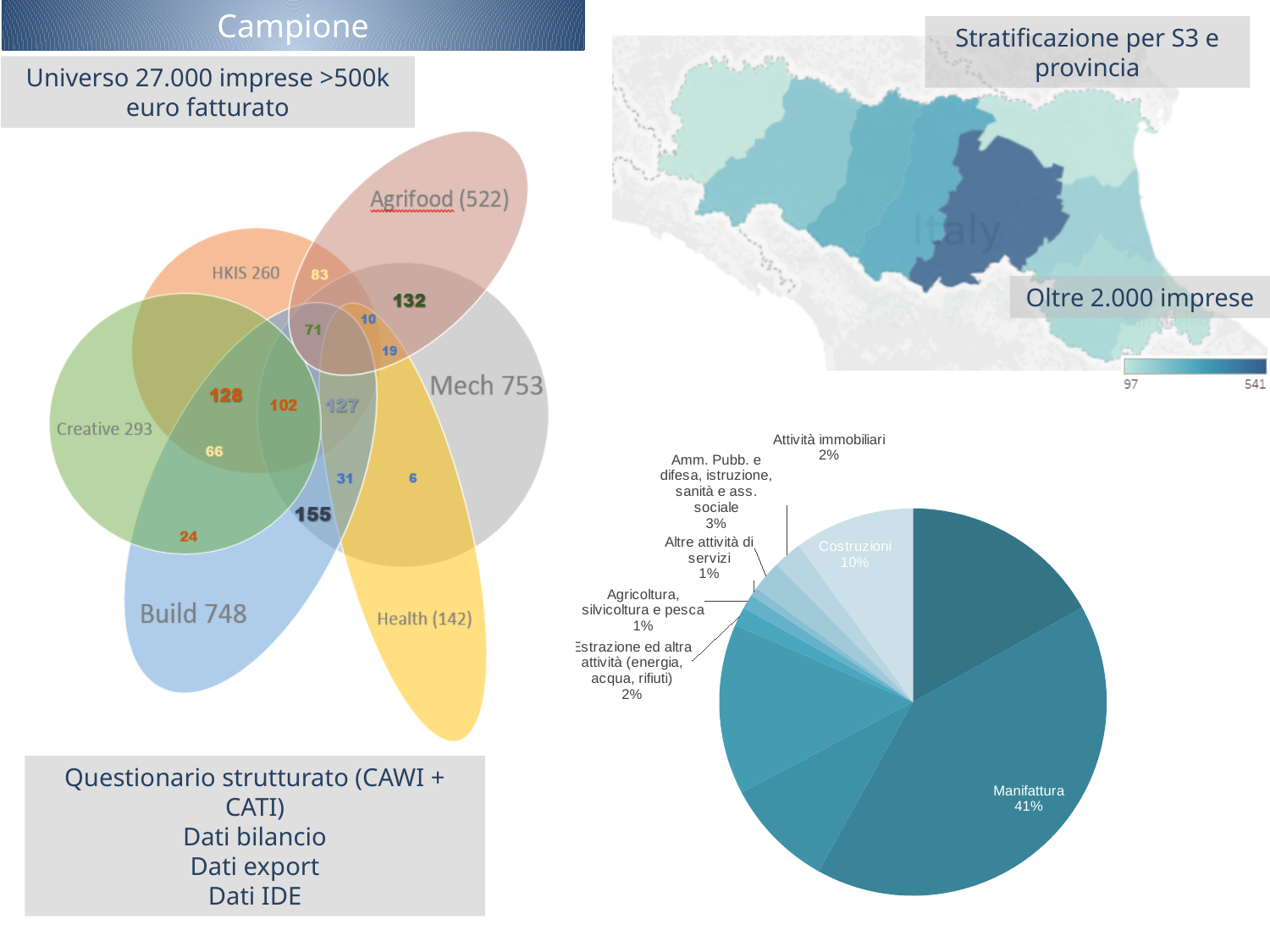
What kind of chart is shown in the lower right of the slide? Pie chart In the pie chart, what share is shown for Costruzioni? 10% In the pie chart, what share is shown for Attività immobiliari? 2% In the pie chart, what share is shown for Manifattura? 41% In the pie chart, how many percentage points larger is Manifattura than Costruzioni? 31 In the pie chart, which is larger: Costruzioni or Attività immobiliari? Costruzioni In the pie chart, what share is shown for Altre attività di servizi? 1% In the pie chart, which labelled category has the largest share? Manifattura In the pie chart, what share is shown for Amm. Pubb. e difesa, istruzione, sanità e ass. sociale? 3% In the pie chart, what share is shown for Estrazione ed altra attività (energia, acqua, rifiuti)? 2% In the Venn diagram on the left, how many firms are indicated for Mech? 753 In the pie chart, what share is shown for Agricoltura, silvicoltura e pesca? 1%